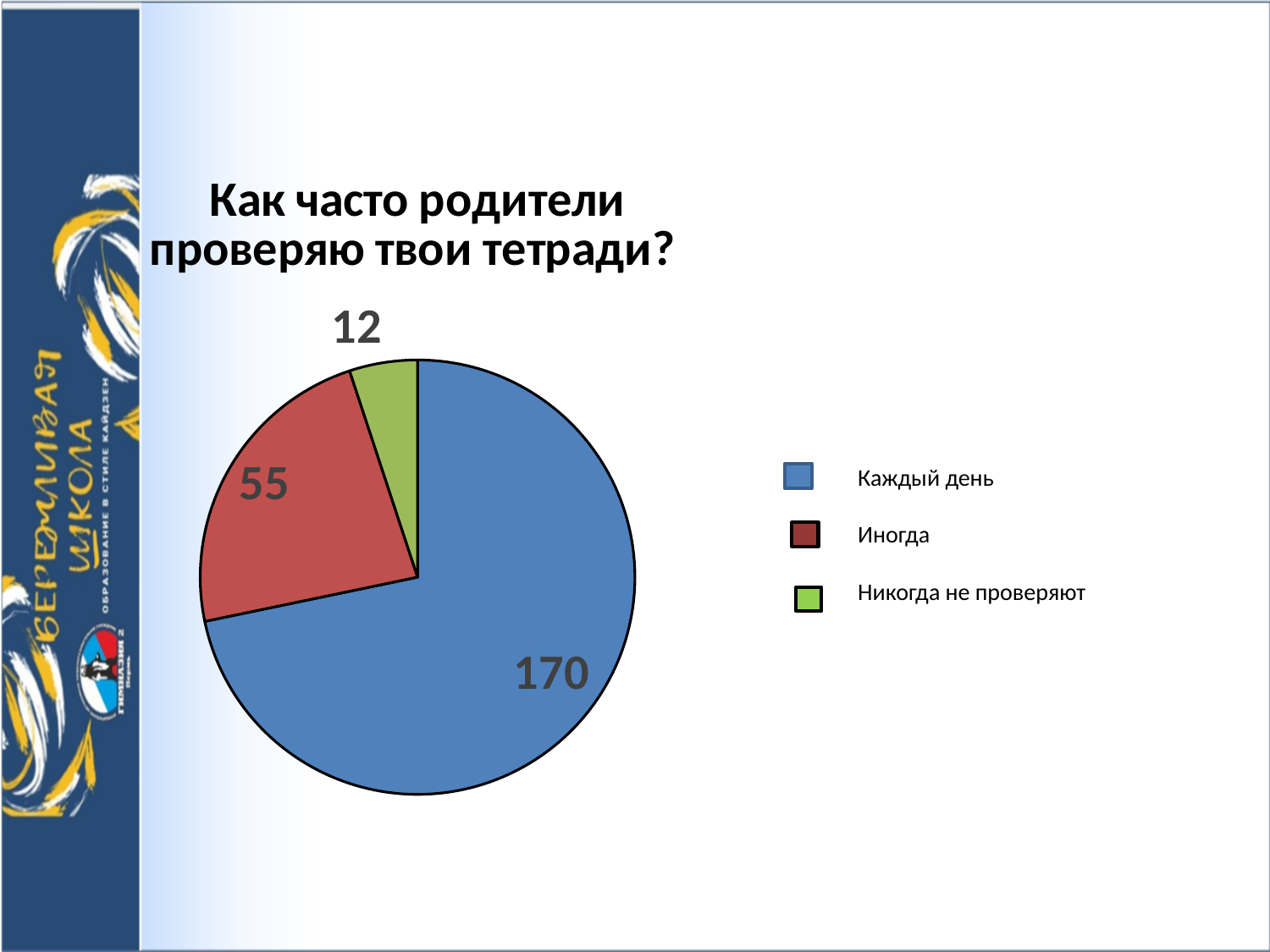
Which category has the largest slice of the pie? Каждый день Which is larger, the value for "Иногда" or the value for "Никогда не проверяют"? Иногда What colour is the slice for "Иногда"? red What is the difference between the values for "Иногда" and "Никогда не проверяют"? 43 How many categories does the pie chart have? 3 What kind of chart is shown on the slide? pie chart What is the difference between the values for "Каждый день" and "Иногда"? 115 Which category has the smallest slice of the pie? Никогда не проверяют What is the value for "Никогда не проверяют"? 12 What is the value for "Каждый день"? 170 What is the title of the chart? Как часто родители проверяю твои тетради? What is the value for "Иногда"? 55